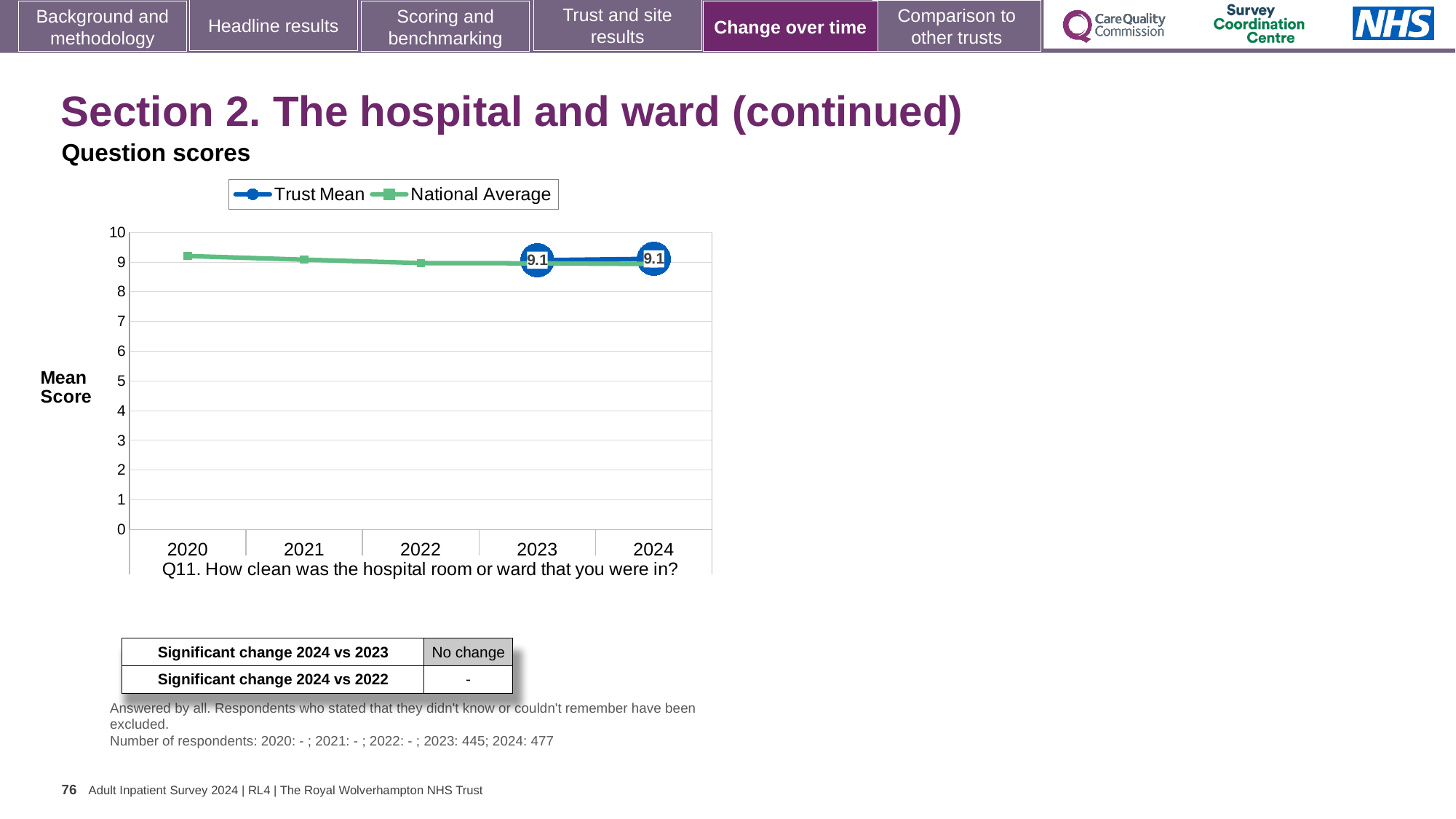
What is the Trust Mean value for 2023? 9.1 Is the National Average value for 2022 greater or less than 5? greater What kind of chart is shown on the slide? Line chart How many series does the legend list? 2 What is the difference between the Trust Mean values for 2024 and 2023? 0 How many years are shown along the x axis? 5 What is the label on the y axis of the chart? Mean Score Is the National Average value for 2020 greater or less than 8? greater What are the two series named in the legend? Trust Mean and National Average Does the National Average rise or fall from 2020 to 2024? falls For how many years is a Trust Mean value plotted? 2 What is the Trust Mean value for 2024? 9.1